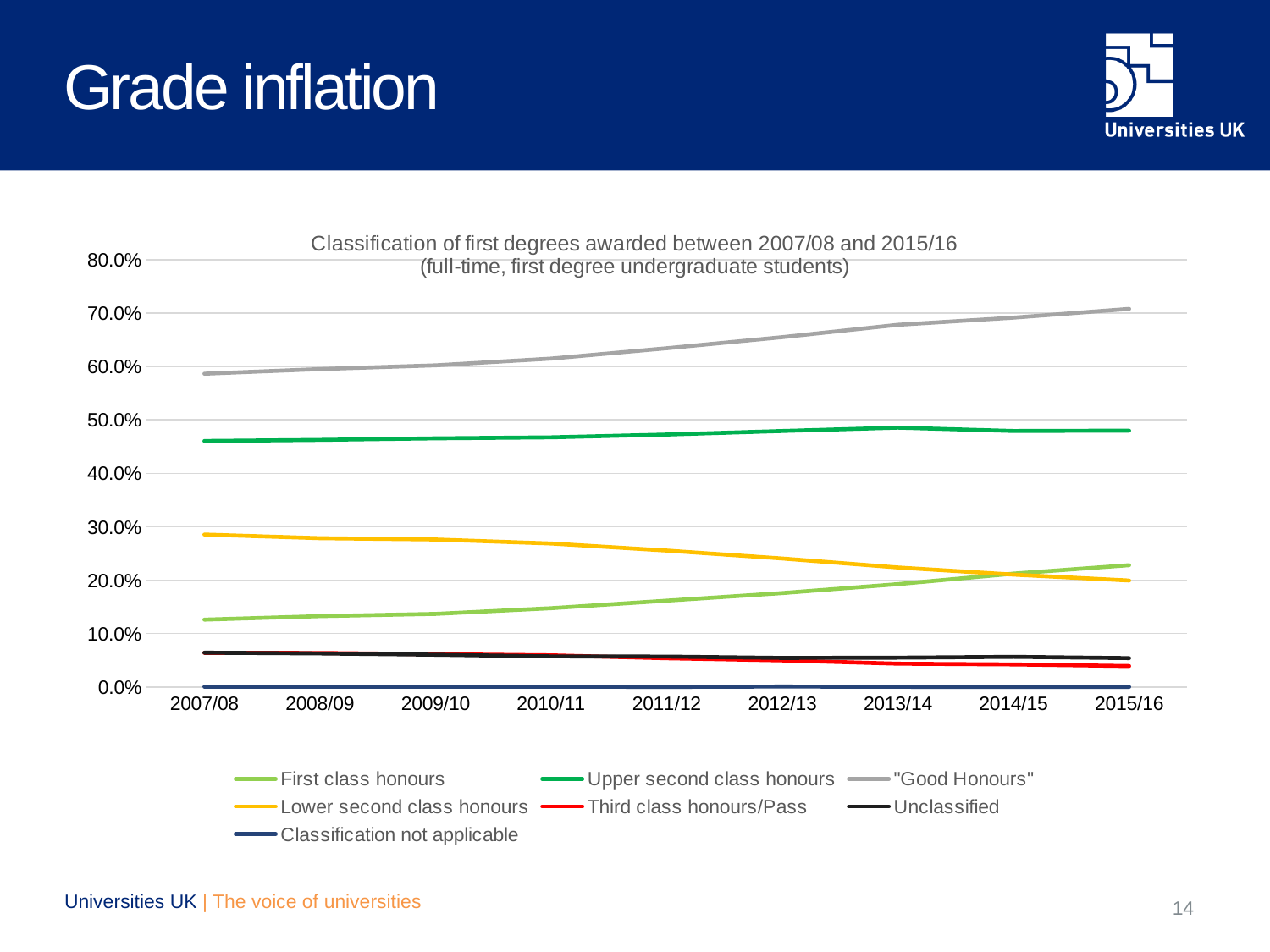
Does the "Good Honours" line rise or fall from 2007/08 to 2015/16? Rises What kind of chart is shown on the slide? Line chart Is the value for Third class honours/Pass in 2015/16 greater or less than 10.0%? less Does the First class honours line rise or fall across the years shown? Rises Which series has the highest value in 2015/16? "Good Honours" How many academic years are plotted along the x axis? 9 What is the first line of the chart's title? Classification of first degrees awarded between 2007/08 and 2015/16 Does the Lower second class honours line rise or fall from 2007/08 to 2015/16? Falls Is the value for "Good Honours" in 2015/16 greater or less than 60.0%? greater Is the value for First class honours in 2015/16 greater or less than 20.0%? greater Which series has the lowest values across all years shown? Classification not applicable How many series does the legend list? 7